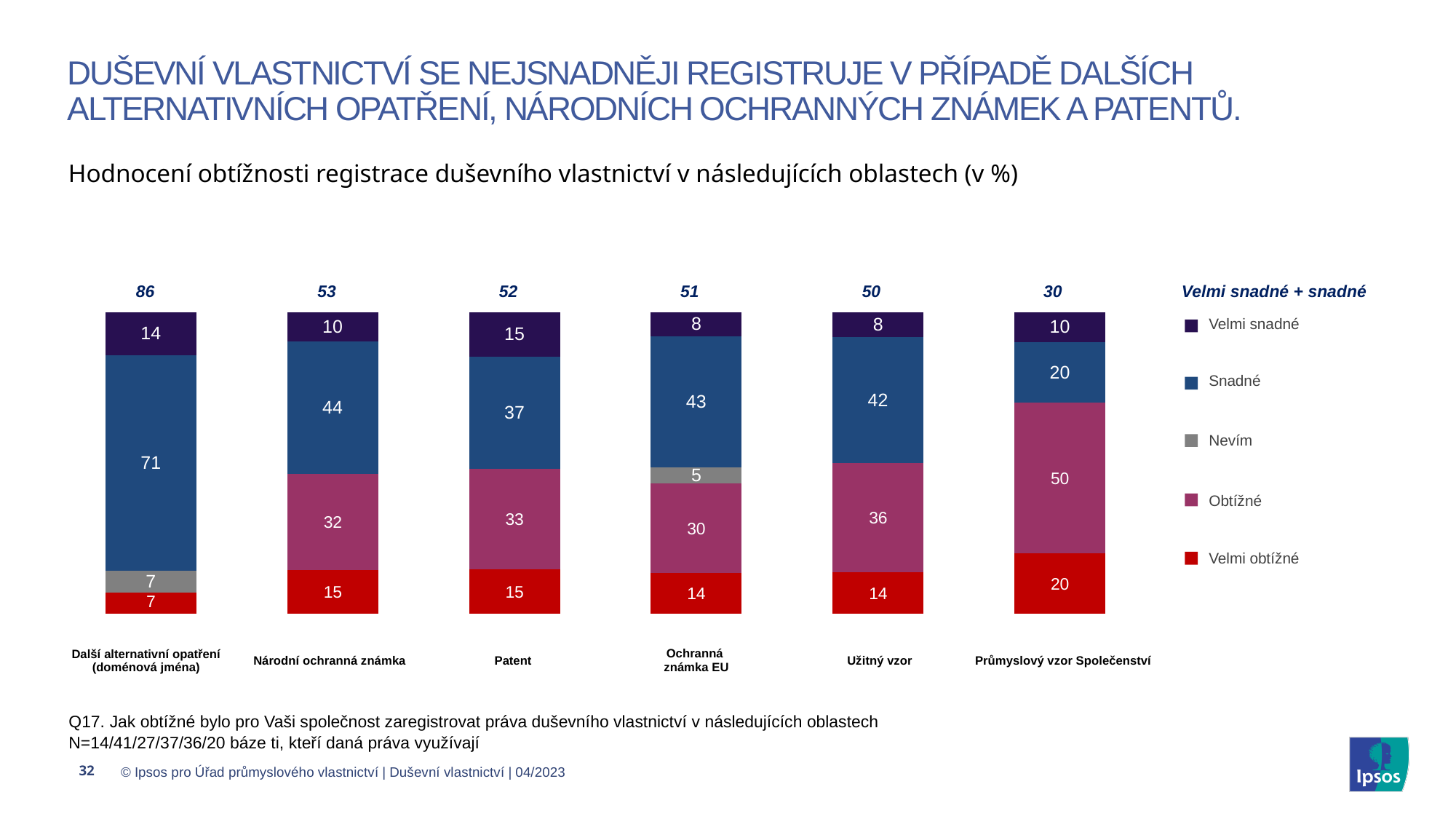
What is the value of Nevím for Ochranná známka EU? 5 What kind of chart is shown on the slide? Stacked bar chart What is the value of Snadné for Patent? 37 What is the Velmi snadné + snadné value shown above the bar for Užitný vzor? 50 What is the value of Velmi obtížné for Průmyslový vzor Společenství? 20 How many categories are shown on the x axis? 6 Which category has the lowest Velmi snadné + snadné value? Průmyslový vzor Společenství Which is larger: the Velmi snadné value for Patent or for Národní ochranná známka? Patent How many series does the legend list? 5 Which category has the highest Velmi snadné + snadné value? Další alternativní opatření (doménová jména) What is the difference between the Obtížné value for Průmyslový vzor Společenství and the Obtížné value for Národní ochranná známka? 18 What colour represents Velmi obtížné in the legend? Red